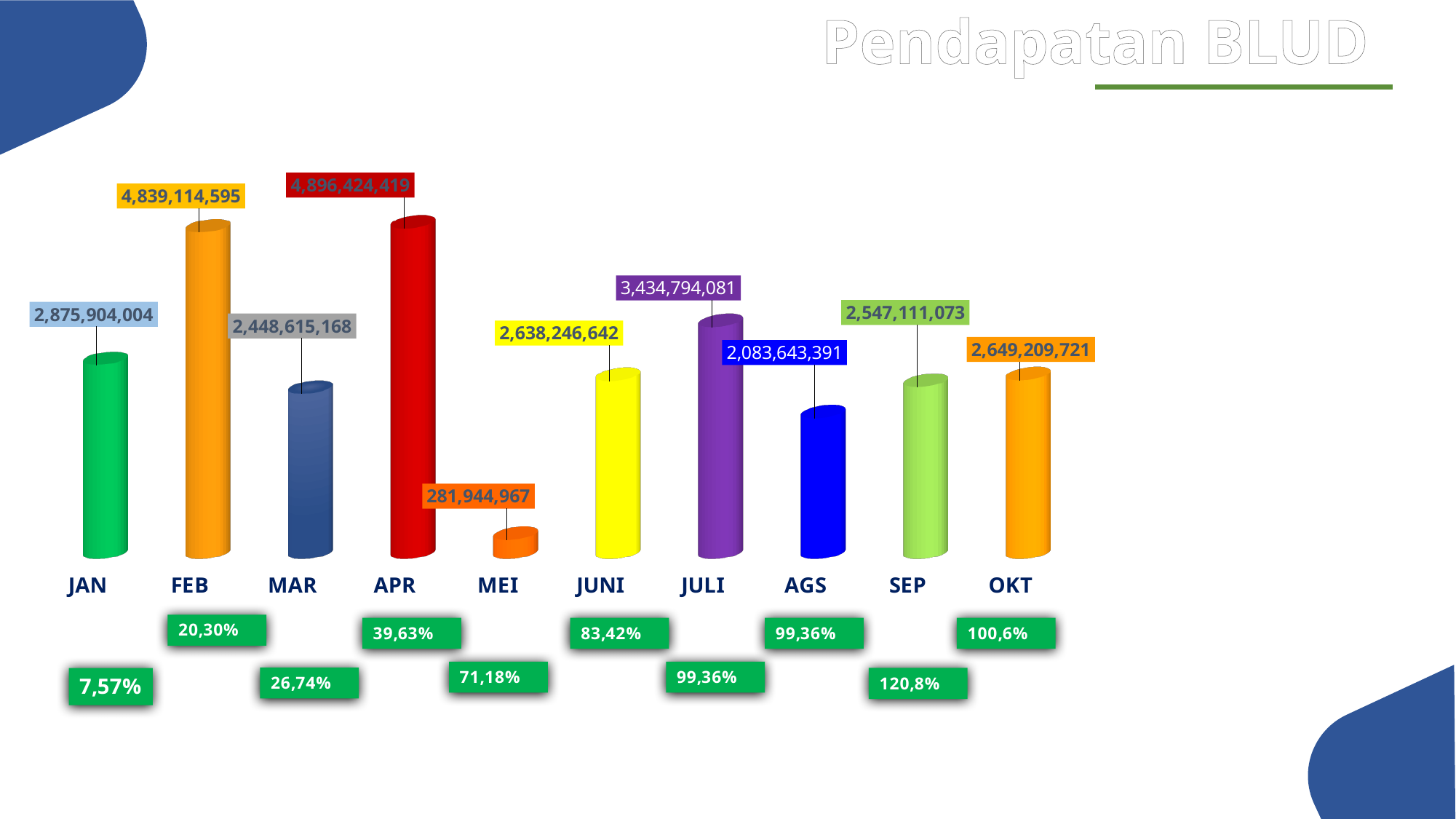
How many months are shown on the chart? 10 What is the value for JULI? 3,434,794,081 What is the value for FEB? 4,839,114,595 What is the title of the chart? Pendapatan BLUD Which is larger, the value for JUNI or the value for JULI? JULI What is the value for MEI? 281,944,967 Which month has the highest value? APR What is the difference between the values for JAN and MAR? 427,288,836 What is the value for OKT? 2,649,209,721 What kind of chart is shown on the slide? bar chart What is the difference between the values for APR and FEB? 57,309,824 Which month has the lowest value? MEI